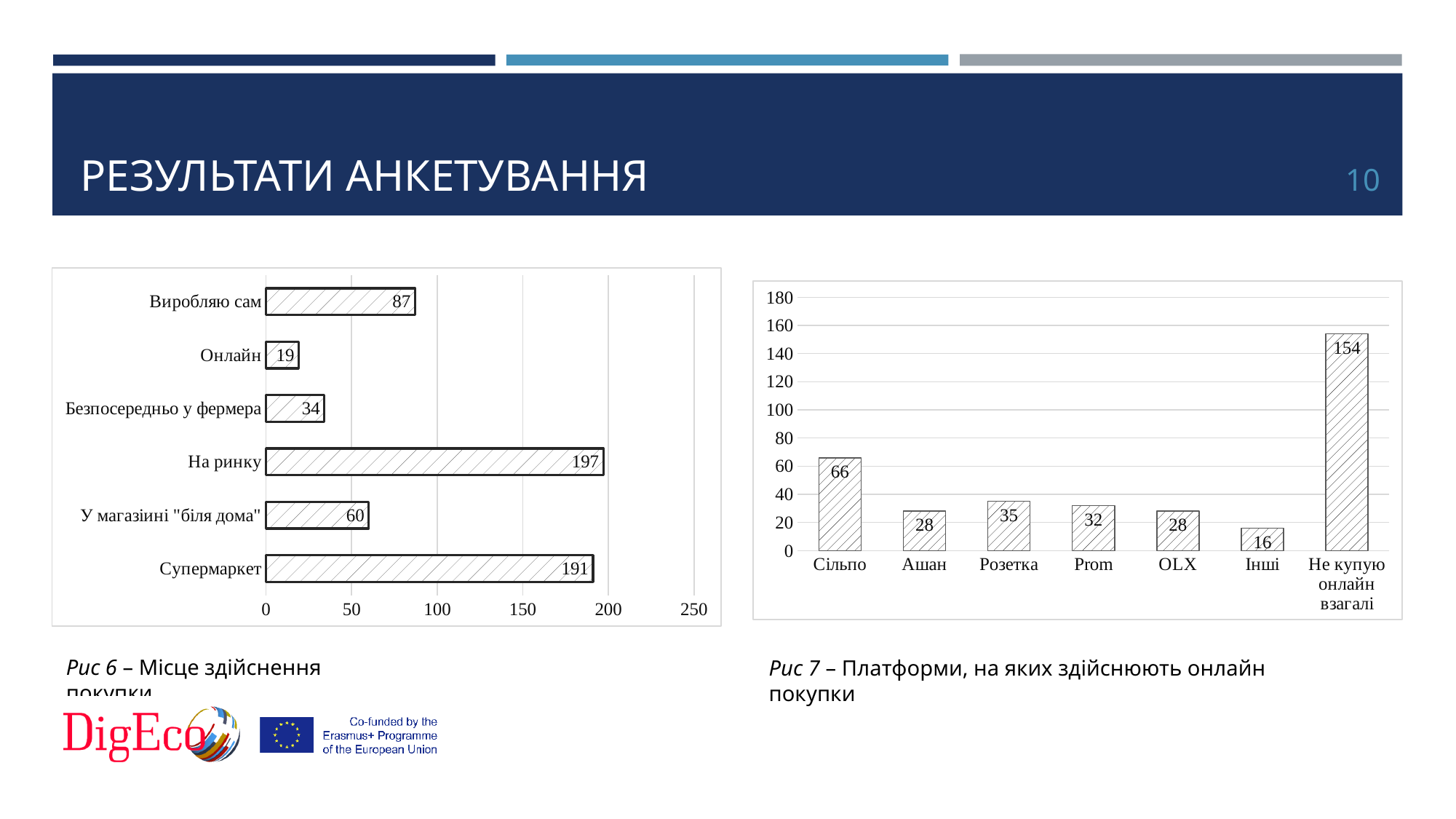
In the right chart (Рис 7), which category has the lowest value? Інші In the left chart (Рис 6), how many categories are shown? 6 In the right chart (Рис 7), how many categories are shown on the x axis? 7 In the left chart (Рис 6), what is the value for На ринку? 197 What type of chart is the left chart (Рис 6)? Bar chart In the left chart (Рис 6), what is the difference between Супермаркет and Виробляю сам? 104 In the right chart (Рис 7), what is the difference between Розетка and Prom? 3 In the left chart (Рис 6), what is the value for Онлайн? 19 In the left chart (Рис 6), which category has the lowest value? Онлайн In the right chart (Рис 7), which category has the highest value? Не купую онлайн взагалі In the left chart (Рис 6), which is larger: У магазіині "біля дома" or Безпосередньо у фермера? У магазіині "біля дома" In the right chart (Рис 7), what is the value for Сільпо? 66